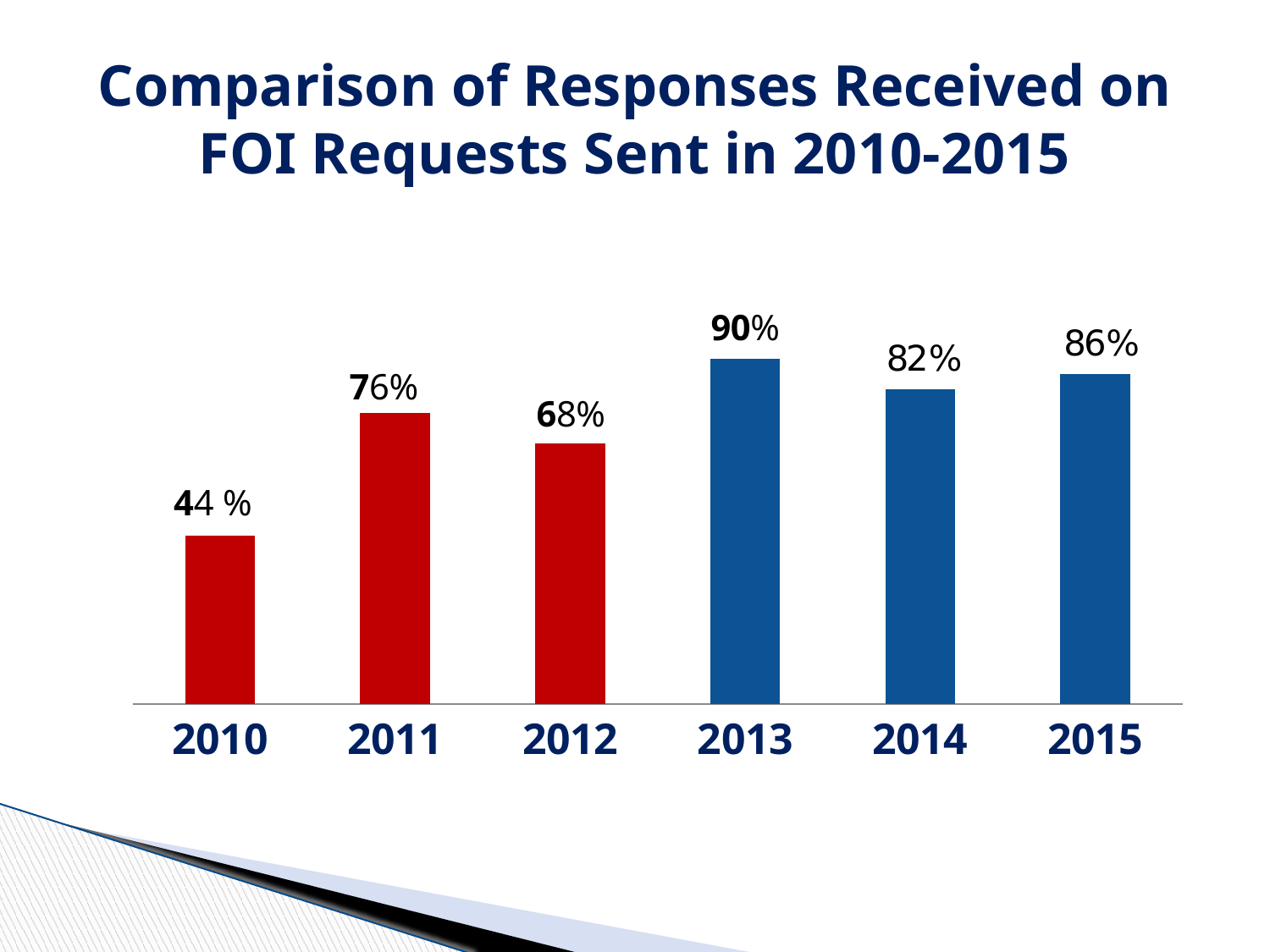
What is the value for 2015? 86% What is the title of the chart? Comparison of Responses Received on FOI Requests Sent in 2010-2015 Which year has the lowest value? 2010 What is the value for 2013? 90% What colour are the bars for 2013, 2014 and 2015? Blue What is the value for 2010? 44 % Which is larger, the value for 2011 or the value for 2012? 2011 What kind of chart is shown on the slide? Bar chart Which year has the highest value? 2013 How many years are shown on the chart? 6 What is the difference between the values for 2011 and 2010? 32% What is the difference between the values for 2013 and 2014? 8%